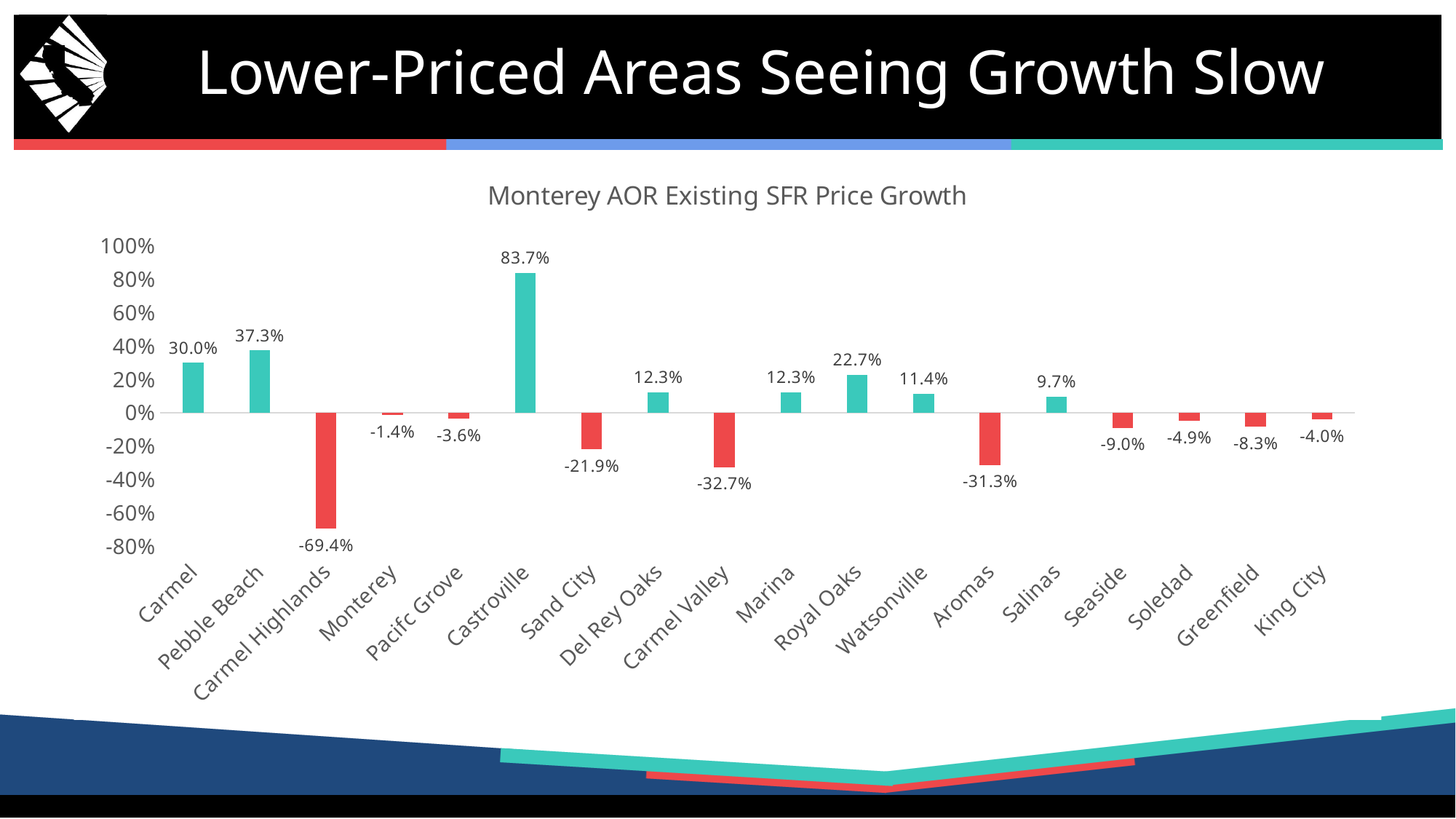
What is the difference between the price growth for Pebble Beach and Carmel? 7.3% What colour are the bars with negative price growth values? Red What is the price growth value for Carmel Highlands? -69.4% Which has a larger price growth value, Royal Oaks or Watsonville? Royal Oaks Which has a lower price growth value, Sand City or Carmel Valley? Carmel Valley Which area has the highest price growth? Castroville What is the title of the chart? Monterey AOR Existing SFR Price Growth What kind of chart is shown on the slide? Bar chart What is the price growth value for Salinas? 9.7% What is the price growth value for Castroville? 83.7% How many areas are shown on the x axis of the chart? 18 Which area has the lowest price growth? Carmel Highlands